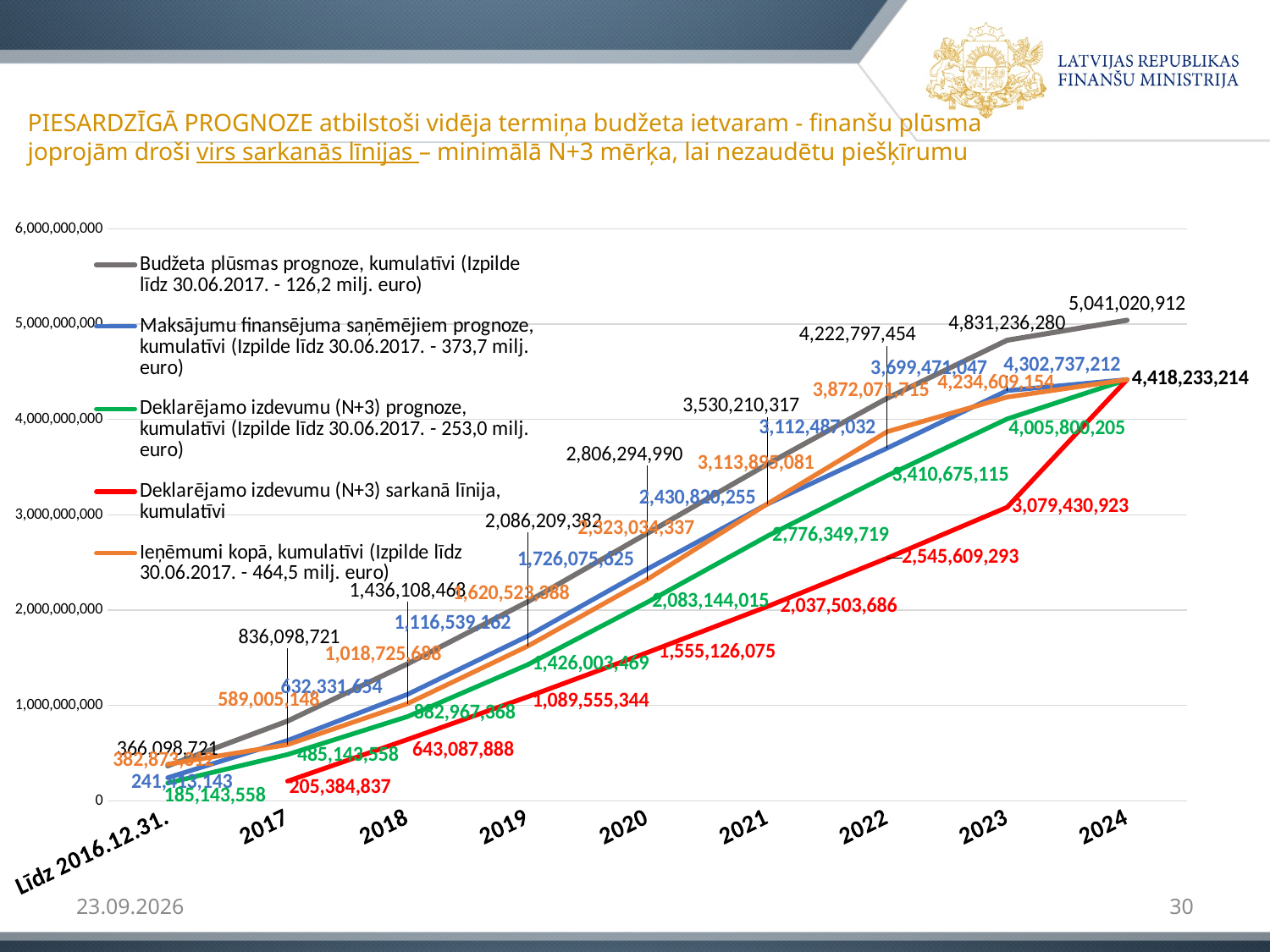
What is the value of the red line (Deklarējamo izdevumu (N+3) sarkanā līnija) for 2023? 3,079,430,923 What is the difference between the grey line's values for 2024 and 2023? 209,784,632 Which series has the highest value in 2024? Budžeta plūsmas prognoze, kumulatīvi (grey line) What is the value of the grey line (Budžeta plūsmas prognoze, kumulatīvi) for 2021? 3,530,210,317 How many categories are shown on the x axis? 9 What is the value of the grey line (Budžeta plūsmas prognoze, kumulatīvi) for 2024? 5,041,020,912 Does the grey line rise or fall from 'Līdz 2016.12.31.' to 2024? rise What is the value of the red line (Deklarējamo izdevumu (N+3) sarkanā līnija) for 2019? 1,089,555,344 How many series does the legend list? 5 What kind of chart is shown on the slide? line chart Is the value of the red line for 2020 greater or less than 2,000,000,000? less What is the value of the green line (Deklarējamo izdevumu (N+3) prognoze) for 2022? 3,410,675,115